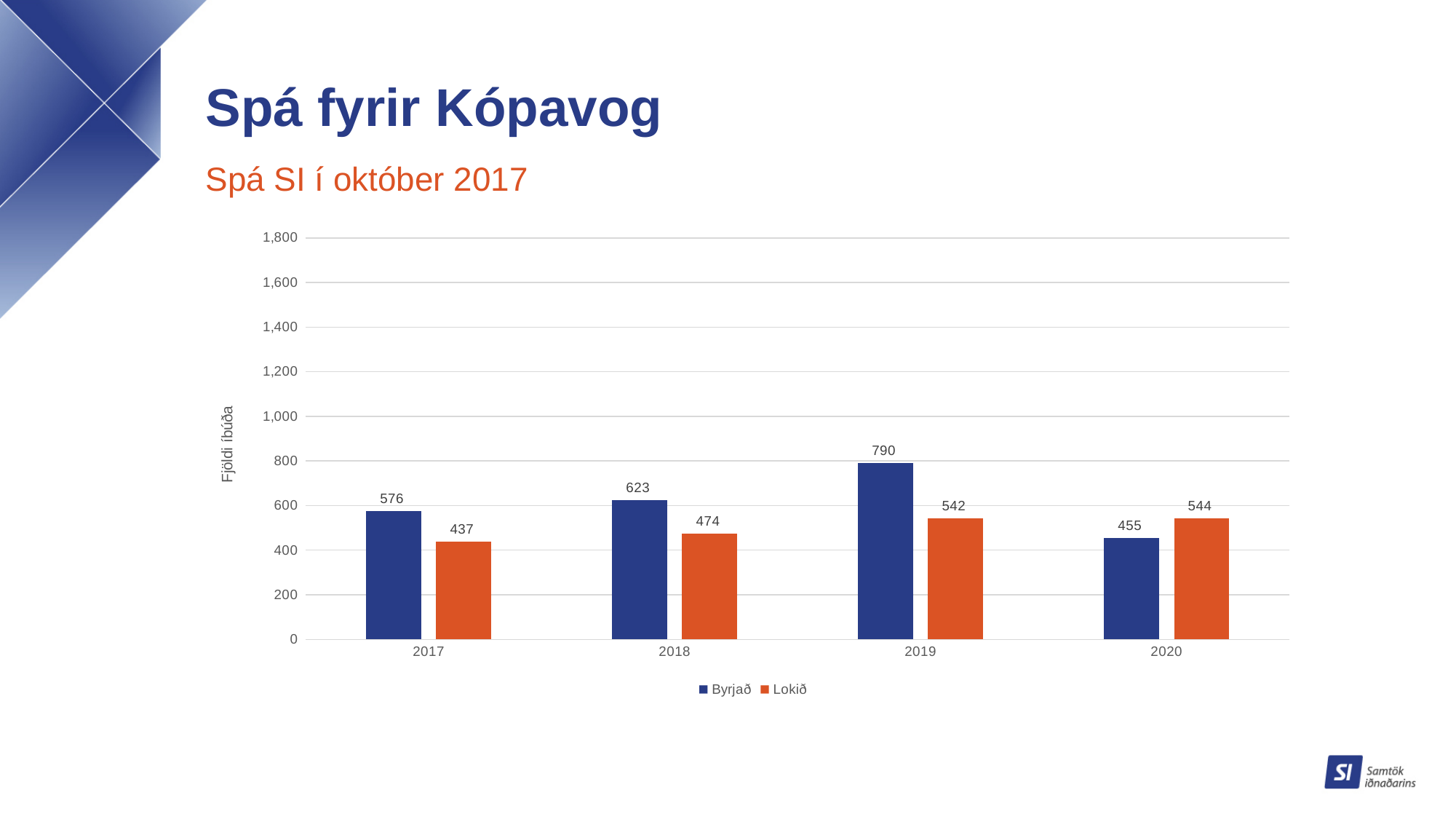
In which year is the Byrjað value highest? 2019 In which year is the Lokið value lowest? 2017 How many series does the legend list? 2 Is the value for Byrjað in 2019 greater or less than 600? greater What is the value for Lokið in 2017? 437 What is the value for Byrjað in 2019? 790 What is the label of the y axis? Fjöldi íbúða How many years are shown on the x axis? 4 What is the difference between Byrjað and Lokið in 2018? 149 What is the value for Byrjað in 2020? 455 Which is larger in 2020, Byrjað or Lokið? Lokið What kind of chart is shown on the slide? Bar chart